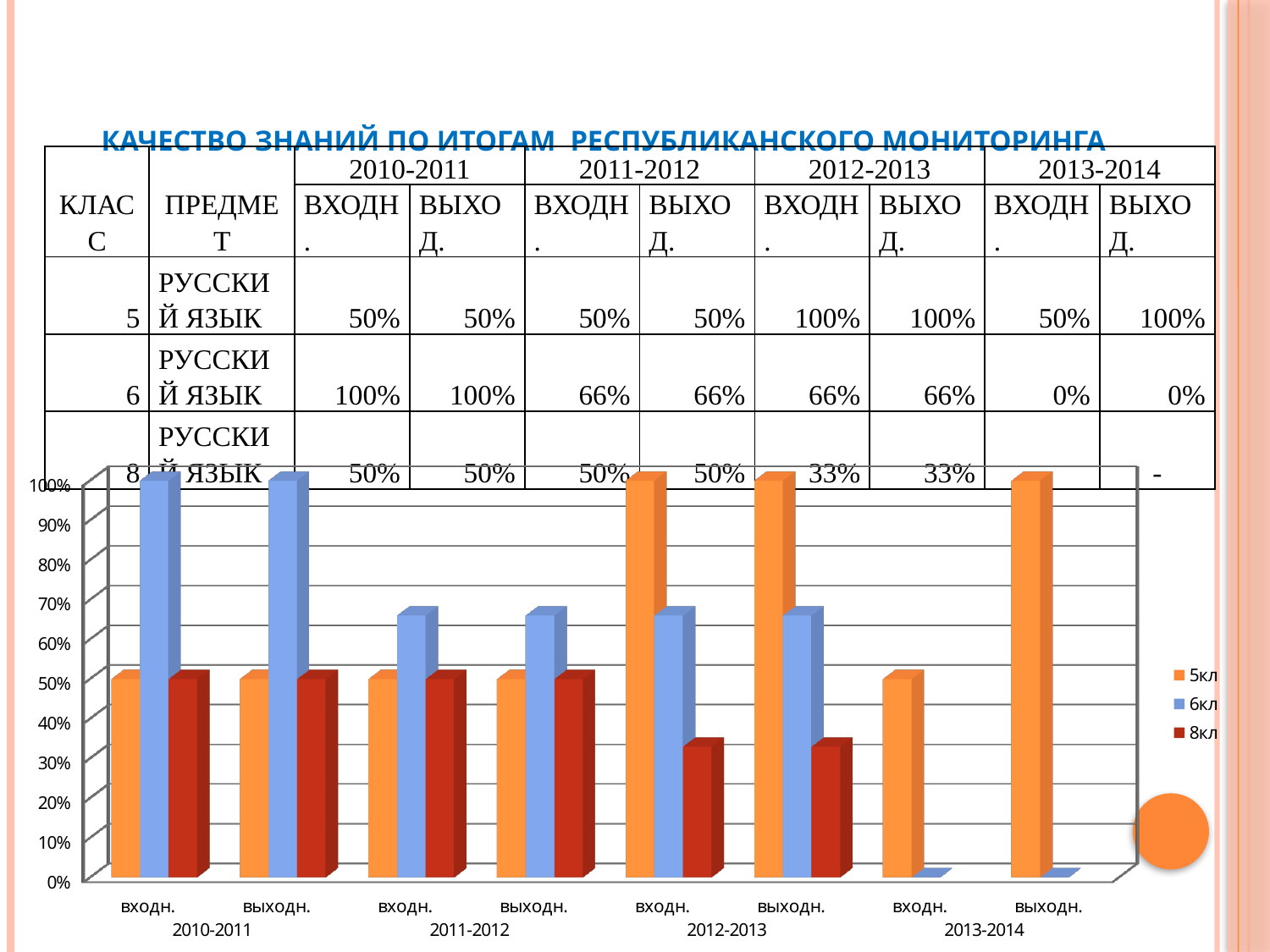
What is the value for 6кл at входн. 2013-2014? 0% What are the legend entries of the chart? 5кл, 6кл, 8кл Which series has the highest value at выходн. 2010-2011? 6кл What kind of chart is shown on the slide? bar chart What is the value for 5кл at входн. 2010-2011? 50% Is the value for 8кл at входн. 2012-2013 greater or less than 40%? less How many categories are shown along the x axis of the chart? 8 Which series has the higher value at входн. 2012-2013, 5кл or 6кл? 5кл What is the value for 6кл at входн. 2010-2011? 100% Is the value for 6кл at входн. 2011-2012 greater or less than 60%? greater What is the value for 5кл at выходн. 2013-2014? 100% How many series does the chart legend list? 3